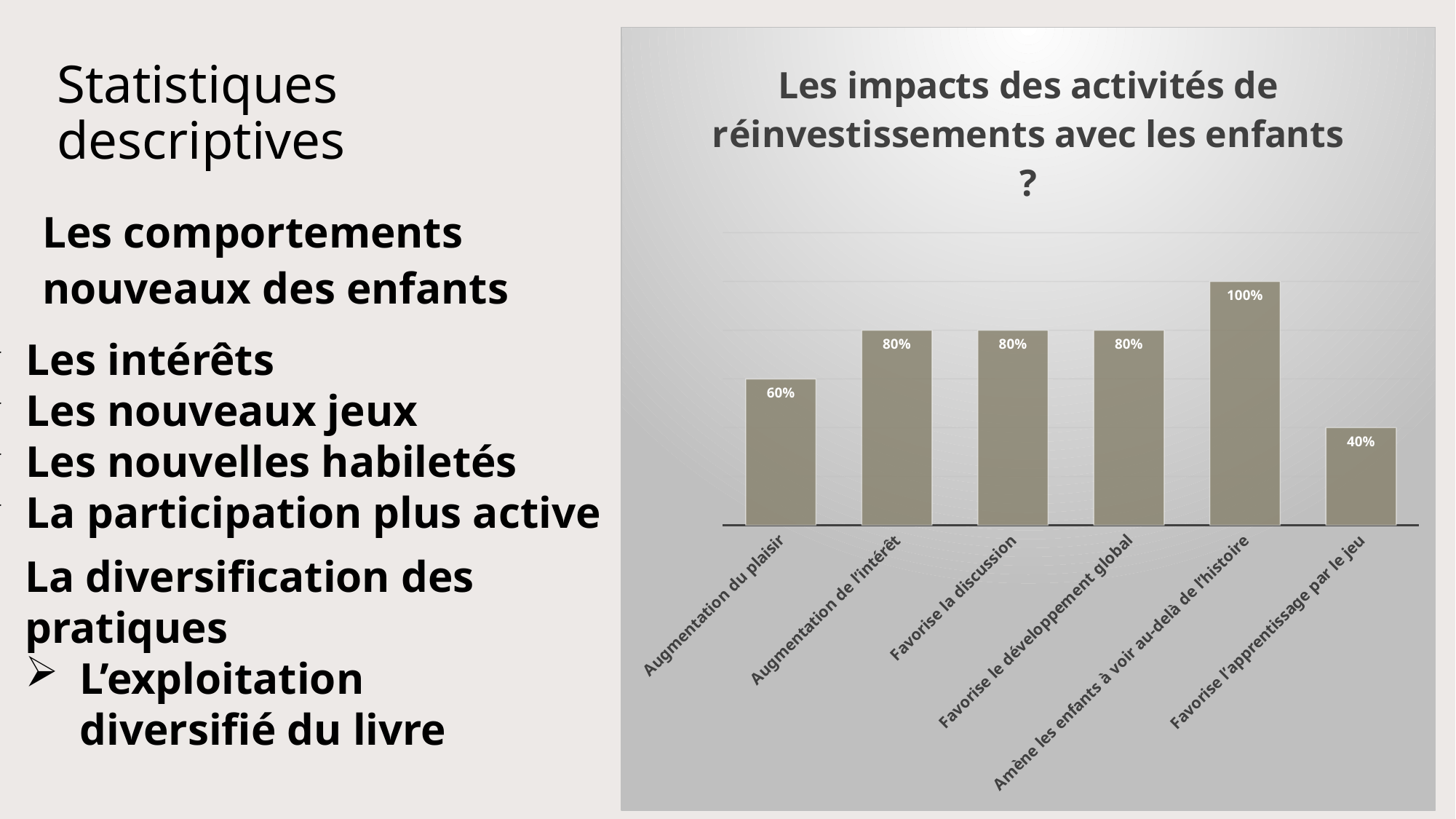
What is the value for "Augmentation du plaisir"? 60% Which is larger, the value for "Augmentation du plaisir" or the value for "Favorise le développement global"? Favorise le développement global What is the difference between the values for "Augmentation de l'intérêt" and "Augmentation du plaisir"? 20% What is the value for "Favorise la discussion"? 80% What is the difference between the values for "Amène les enfants à voir au-delà de l'histoire" and "Favorise l'apprentissage par le jeu"? 60% Which category has the lowest value? Favorise l'apprentissage par le jeu How many categories are shown in the chart? 6 What kind of chart is shown on the slide? Bar chart What is the value for "Favorise l'apprentissage par le jeu"? 40% Which category has the highest value? Amène les enfants à voir au-delà de l'histoire What is the title of the chart? Les impacts des activités de réinvestissements avec les enfants ? What is the value for "Amène les enfants à voir au-delà de l'histoire"? 100%